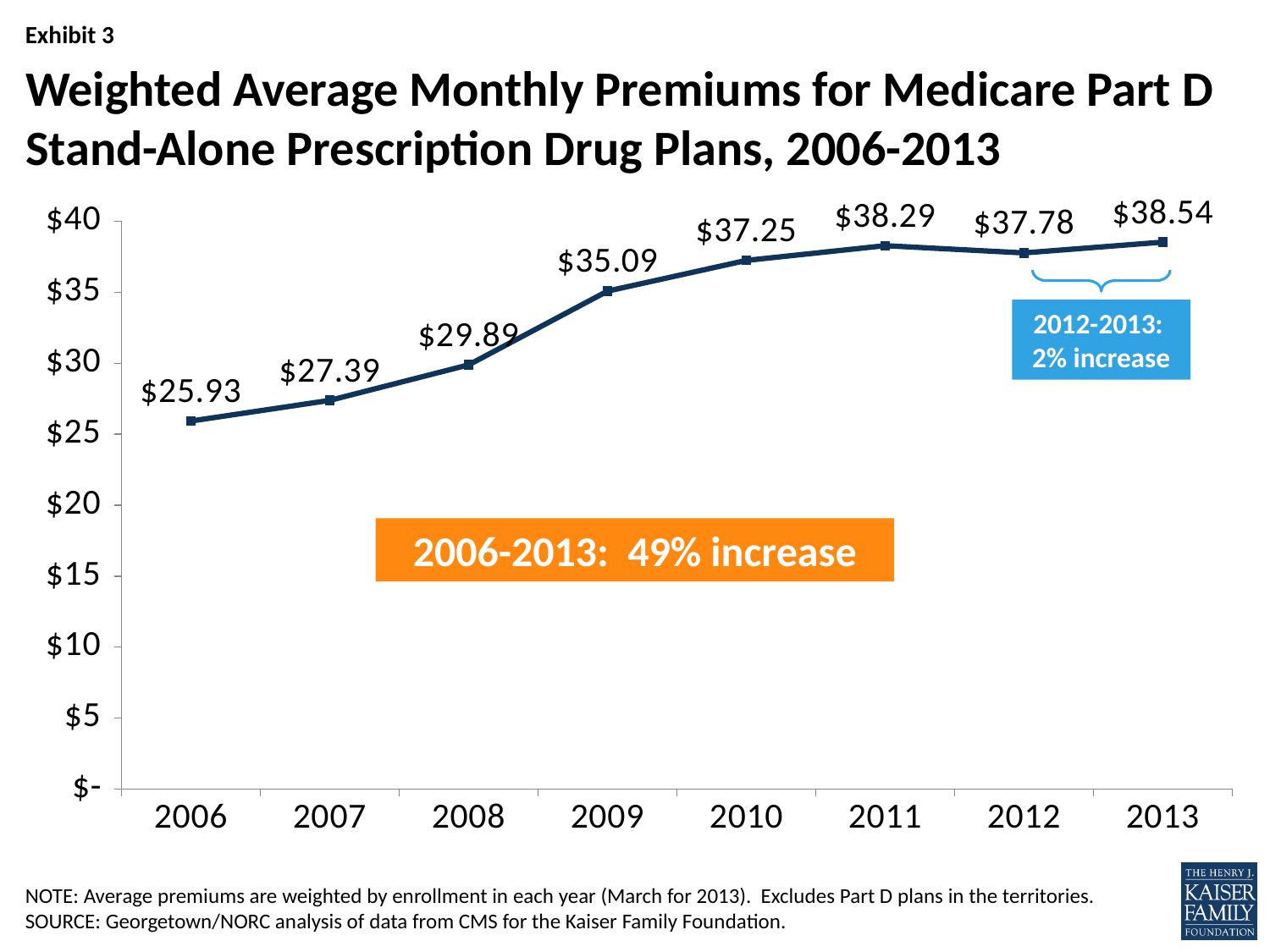
Which year had a higher premium, 2011 or 2012? 2011 Which year had the lowest weighted average monthly premium? 2006 What was the weighted average monthly premium in 2006? $25.93 What is the difference between the 2011 premium and the 2012 premium? $0.51 What kind of chart is shown on the slide? line chart What was the weighted average monthly premium in 2009? $35.09 What was the weighted average monthly premium in 2013? $38.54 How many years are plotted on the chart? 8 Is the premium for 2008 greater or less than $30? less Which year had the highest weighted average monthly premium? 2013 What percentage increase does the orange box report for 2006-2013? 49% increase What is the difference between the 2013 premium and the 2006 premium? $12.61